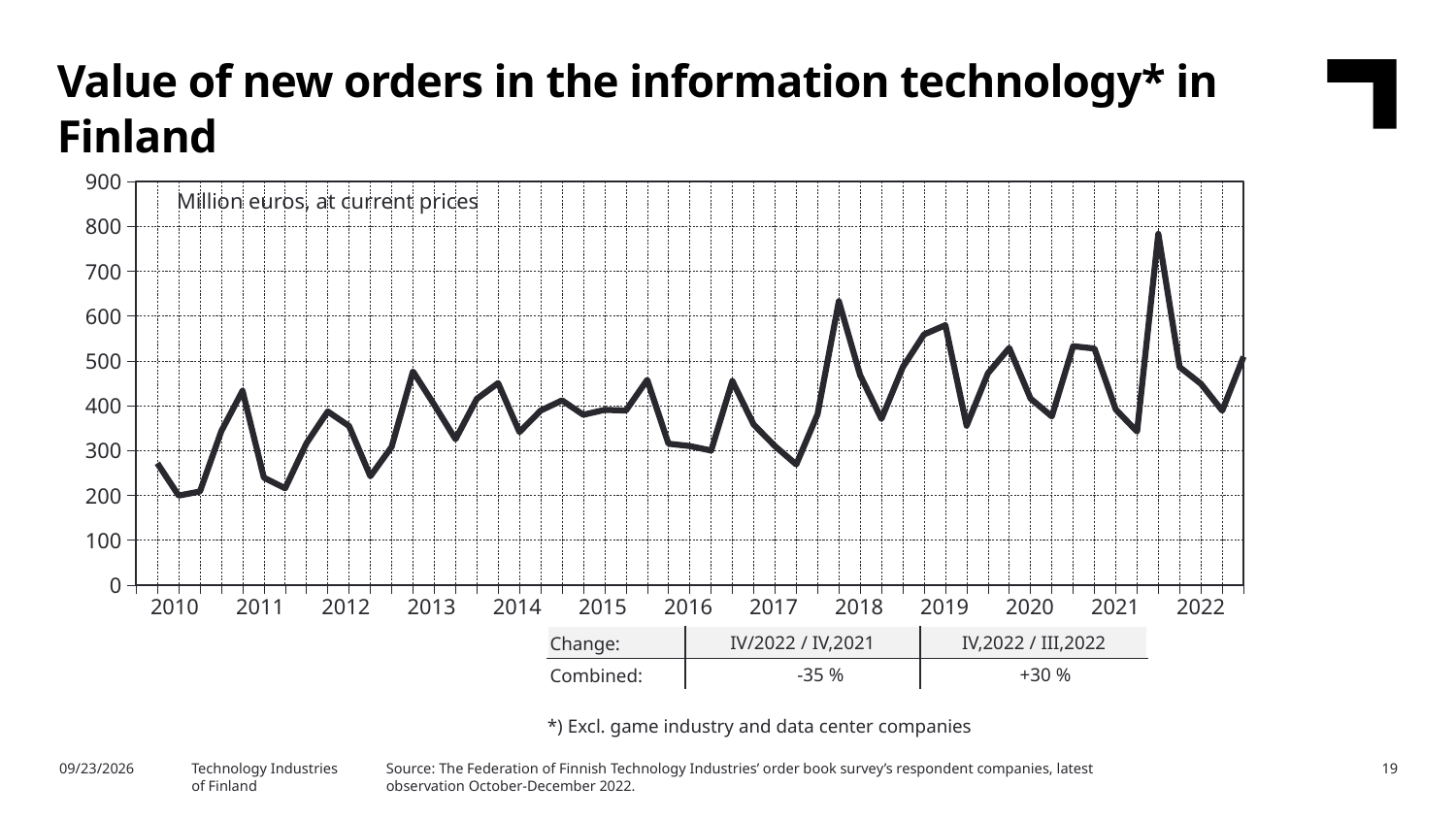
How many years are labelled on the x axis of the chart? 13 Is the highest peak of the line, in 2021, greater or less than 700? greater What kind of chart is shown on the slide? Line chart Is the peak of the line in 2018 greater or less than 500? greater According to the table below the chart, what is the combined change for IV/2022 compared with IV/2021? -35 % What is the title of the chart? Value of new orders in the information technology* in Finland Is the lowest point of the line in 2010 greater or less than 300? less In what unit are the values on the chart expressed? Million euros, at current prices In which year does the line reach its highest peak? 2021 According to the table below the chart, what is the combined change for IV/2022 compared with III/2022? +30 % Does the line generally rise or fall from 2010 to 2022? rise